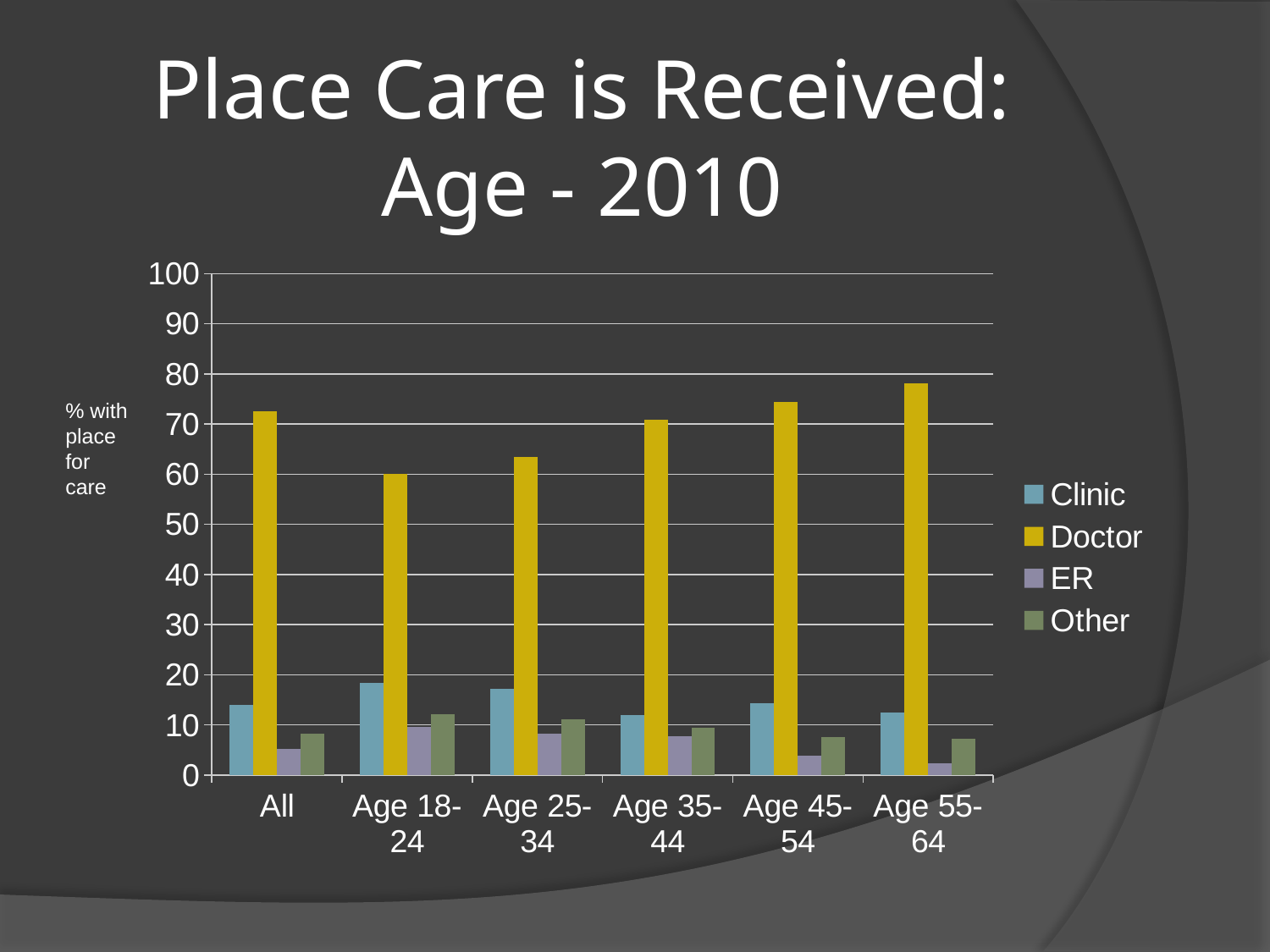
What is the label on the vertical axis of the chart? % with place for care What kind of chart is shown on the slide? Bar chart How many age categories are shown on the x axis? 6 How many series does the legend list? 4 Is the Doctor value for Age 25-34 greater or less than 70? less Is the Clinic value for All greater or less than 20? less Which age category has the lowest ER value? Age 55-64 Is the Doctor value for Age 55-64 greater or less than 70? greater Which is larger, the Doctor value for Age 55-64 or the Doctor value for All? Age 55-64 Which age category has the highest Doctor value? Age 55-64 Do the ER values rise or fall from Age 18-24 to Age 55-64? fall Which age category has the lowest Doctor value? Age 18-24